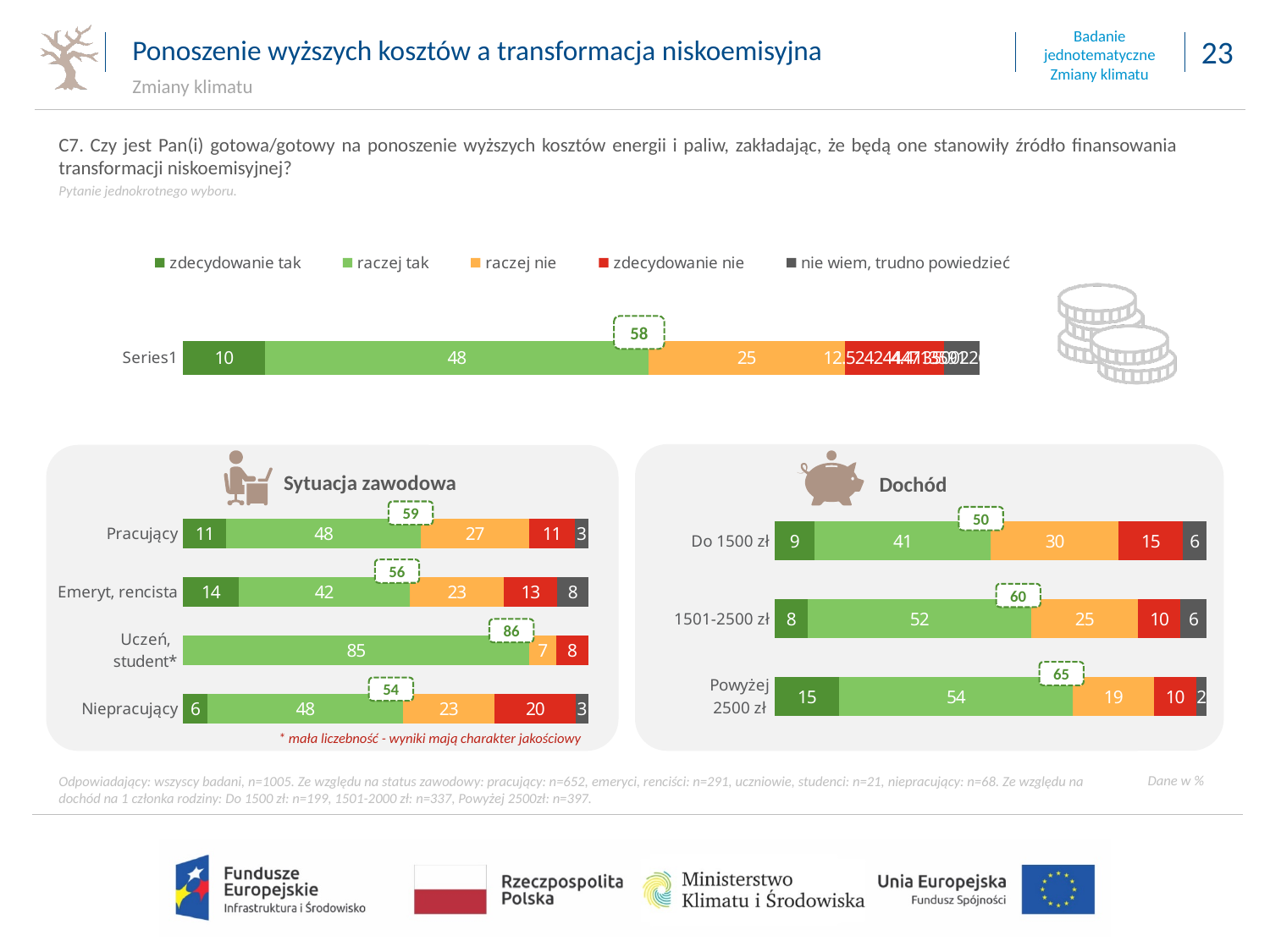
How many series does the legend at the top of the slide list? 5 In the 'Sytuacja zawodowa' chart, is the 'zdecydowanie nie' value larger for 'Emeryt, rencista' or for 'Pracujący'? Emeryt, rencista How many categories are shown in the 'Dochód' chart? 3 In the 'Sytuacja zawodowa' chart, what is the value of 'zdecydowanie nie' for 'Niepracujący'? 20 What kind of chart is the 'Sytuacja zawodowa' chart? Stacked bar chart In the 'Dochód' chart, which income group has the highest 'raczej nie' value? Do 1500 zł In the 'Sytuacja zawodowa' chart, what is the value of 'raczej tak' for 'Uczeń, student*'? 85 In the 'Dochód' chart, what is the combined 'zdecydowanie tak' and 'raczej tak' value shown in the callout for 'Powyżej 2500 zł'? 65 In the 'Dochód' chart, what is the value of 'zdecydowanie tak' for 'Powyżej 2500 zł'? 15 In the 'Dochód' chart, what is the difference between the 'raczej tak' values for '1501-2500 zł' and 'Do 1500 zł'? 11 In the top chart (Series1), what is the value of 'raczej tak'? 48 In the 'Sytuacja zawodowa' chart, which group has the lowest 'zdecydowanie tak' value among those with a printed label? Niepracujący